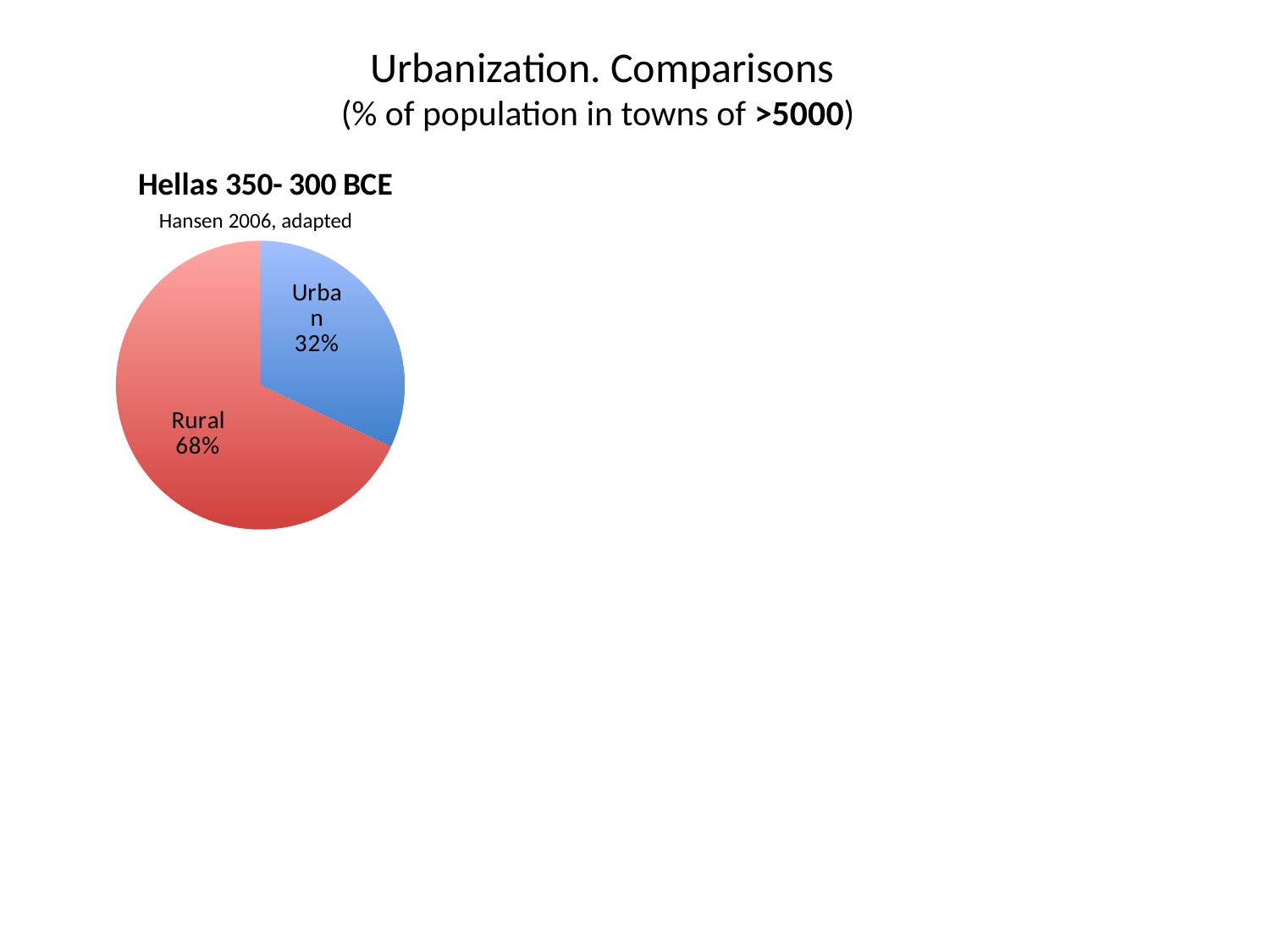
What is the title of the pie chart? Hellas 350- 300 BCE Which slice is the smallest in the pie chart? Urban How many slices does the pie chart have? 2 Which is larger, the Urban slice or the Rural slice? Rural What share of the pie does the Urban slice represent? 32% Which slice is the largest in the pie chart? Rural What is the difference in percentage points between the Rural and Urban slices? 36 What kind of chart is shown on the slide? pie chart What share of the pie does the Rural slice represent? 68% What colour is the Urban slice of the pie chart? blue